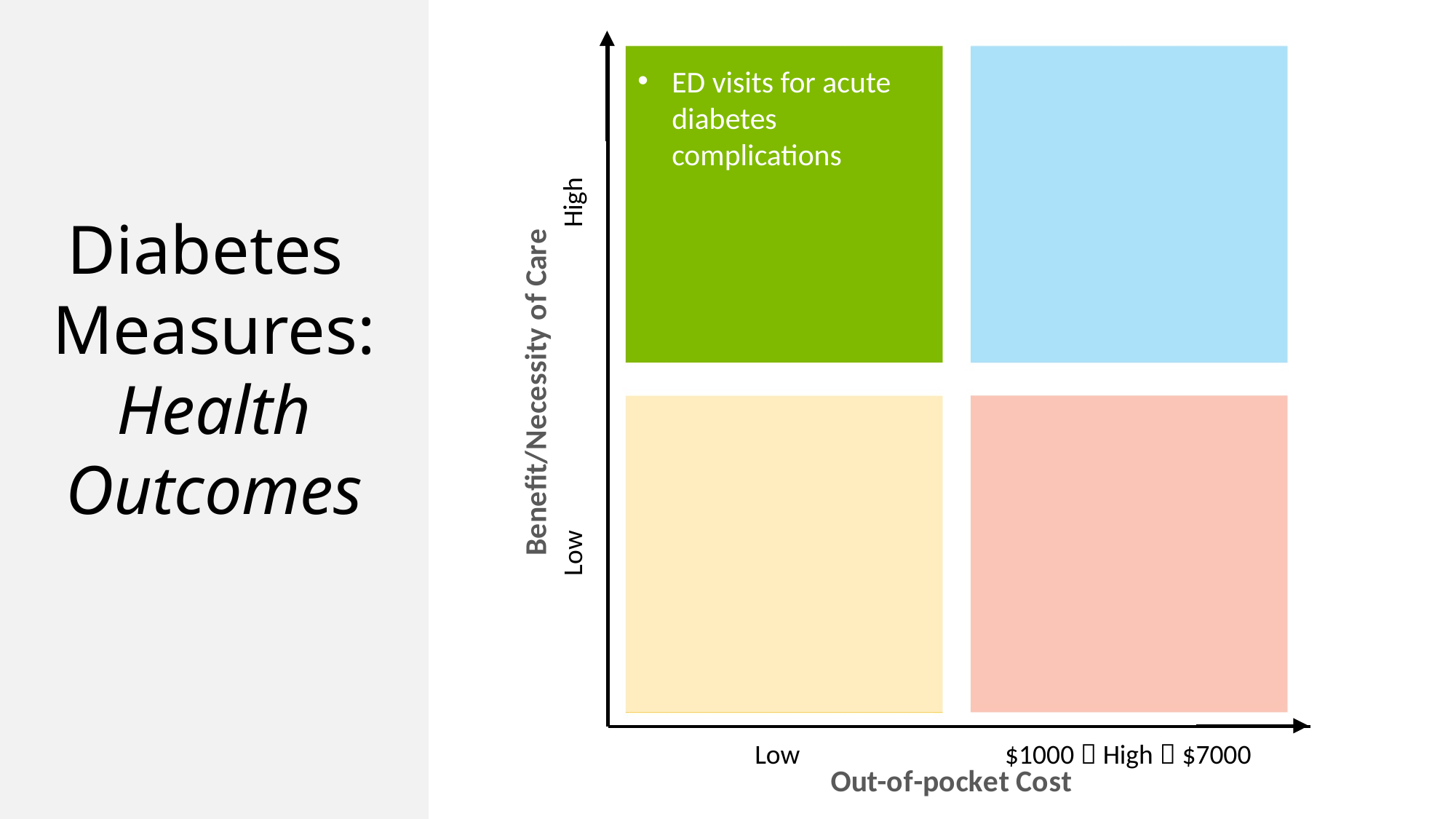
How many quadrants does the chart have? 4 How many items are placed in the quadrants of the chart? 1 What is the benefit/necessity of care level for "ED visits for acute diabetes complications" on the chart? High What is the out-of-pocket cost level for "ED visits for acute diabetes complications" on the chart? Low In which quadrant of the chart is "ED visits for acute diabetes complications" placed? High benefit/necessity of care, low out-of-pocket cost What is the label of the horizontal axis of the chart? Out-of-pocket Cost What kind of chart is shown on the slide? A 2x2 quadrant (matrix) chart What is the label of the vertical axis of the chart? Benefit/Necessity of Care What dollar range is shown for the "High" out-of-pocket cost category on the chart? $1000 to $7000